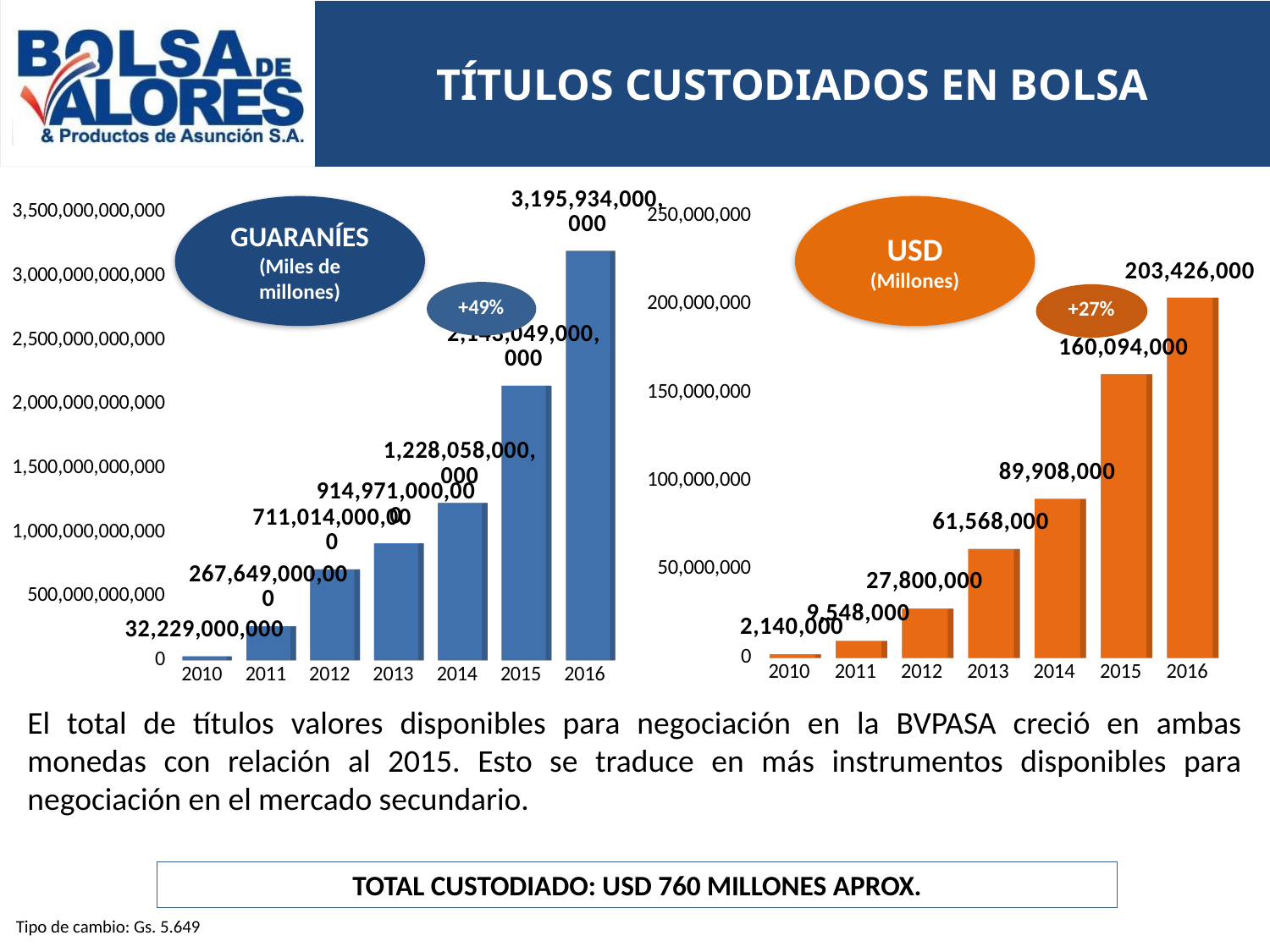
In the USD (Millones) chart, is the value for 2014 greater or less than 100,000,000? less How many years are shown on the x axis of the GUARANÍES chart? 7 In the USD (Millones) chart, what is the value for 2013? 61,568,000 In the USD (Millones) chart, what is the difference between the 2016 and 2015 values? 43,332,000 In the USD (Millones) chart, what is the value for 2015? 160,094,000 What kind of chart is the USD (Millones) chart? bar chart In the USD (Millones) chart, which year has the lowest value? 2010 What growth percentage is shown in the bubble on the USD (Millones) chart? +27% In the GUARANÍES chart, what is the value for 2010? 32,229,000,000 In the USD (Millones) chart, what is the value for 2016? 203,426,000 In the GUARANÍES chart, which year has the highest value? 2016 In the GUARANÍES chart, what is the value for 2016? 3,195,934,000,000